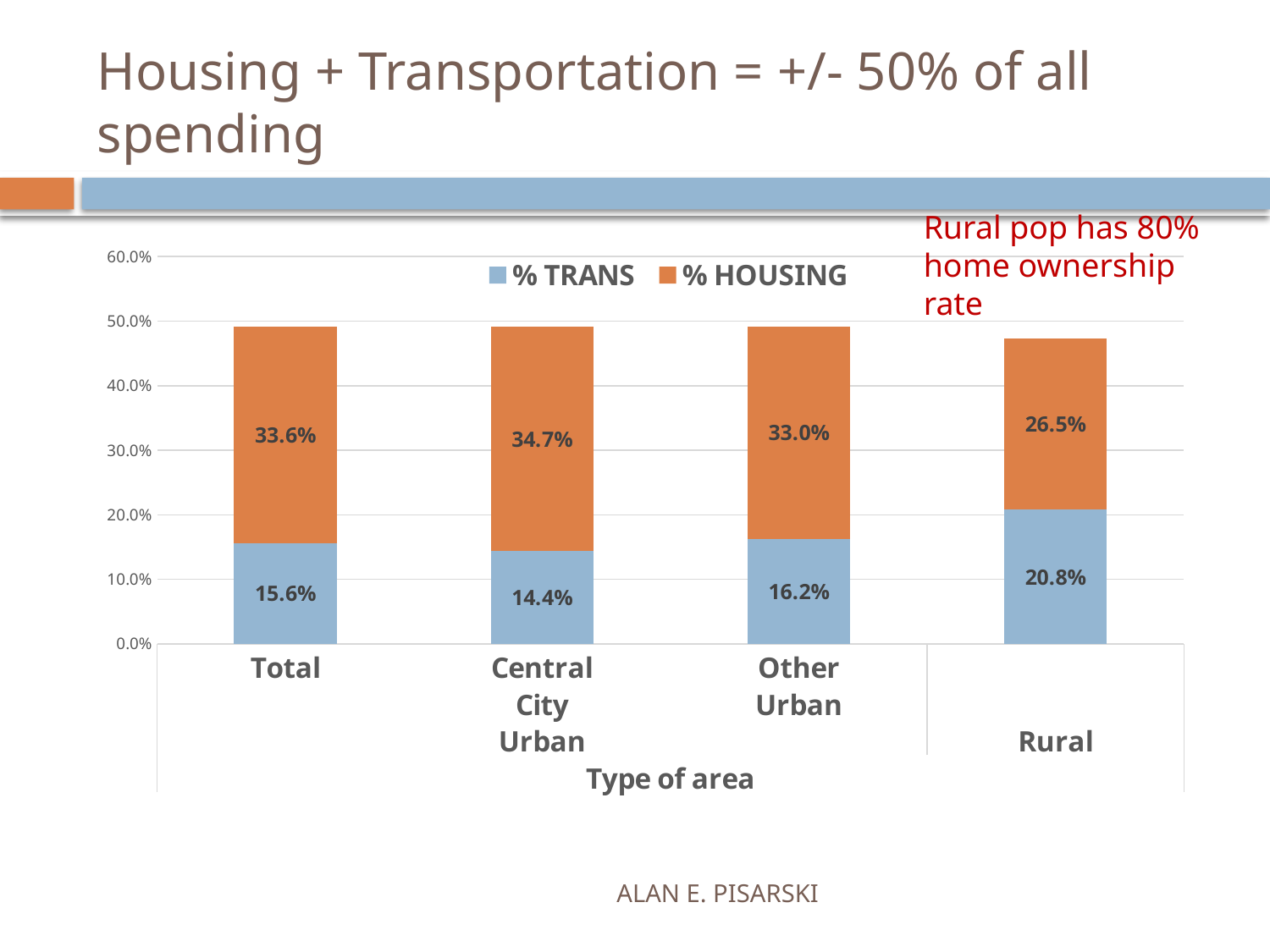
What is the % HOUSING value for Other Urban? 33.0% Which type of area has the lowest % TRANS value? Central City Urban How many series does the legend list? 2 What is the combined total of the stacked bar for Rural? 47.3% What is the % HOUSING value for Central City Urban? 34.7% What is the % TRANS value for Rural? 20.8% What is the difference between the % HOUSING value for Total and the % TRANS value for Total? 18.0% What kind of chart is shown on the slide? Stacked bar chart Which type of area has the lowest % HOUSING value? Rural Is the % HOUSING value larger for Central City Urban or for Rural? Central City Urban Which type of area has the highest % TRANS value? Rural How many types of area are shown on the x axis? 4